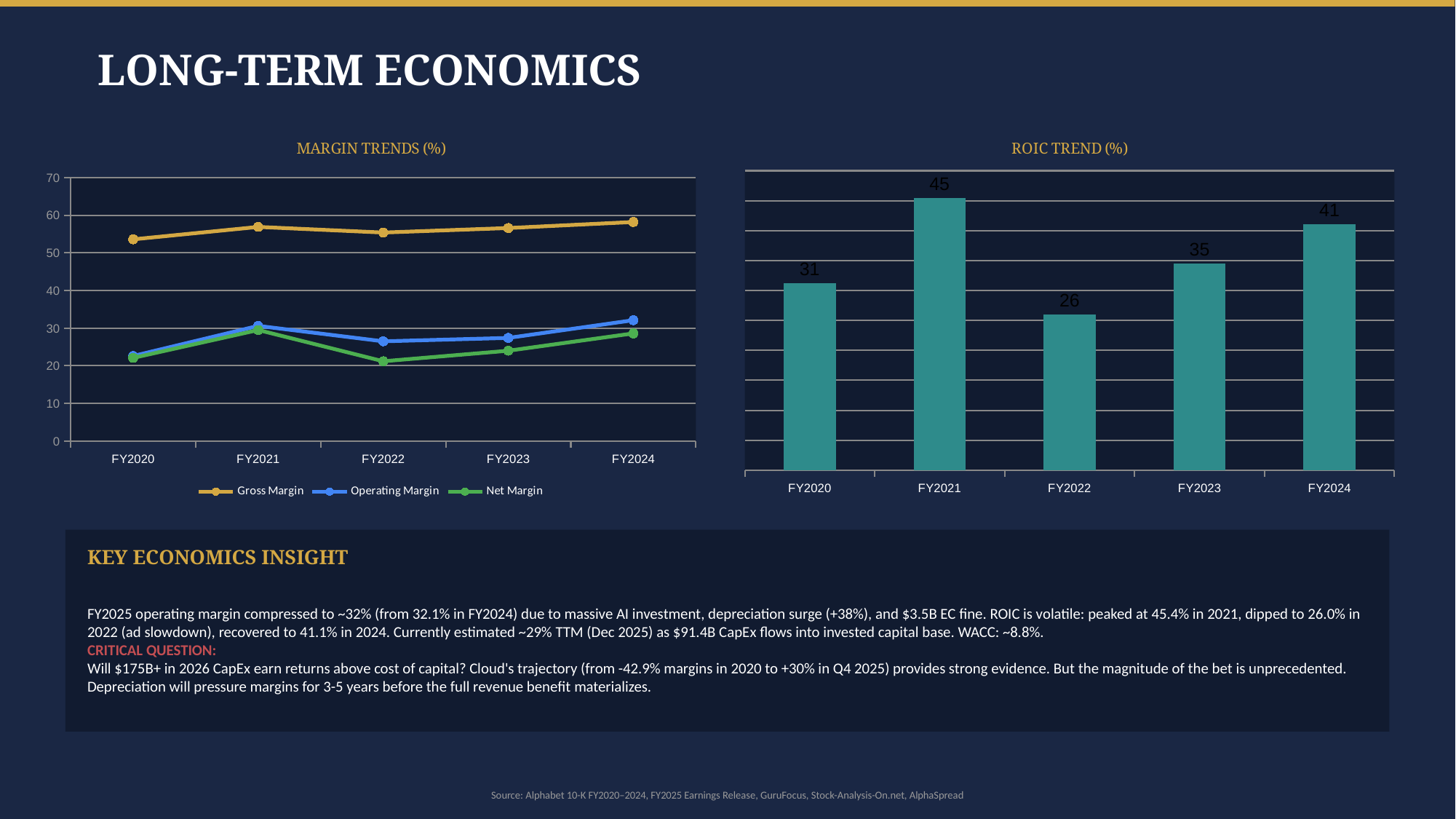
How many series does the legend of the MARGIN TRENDS (%) chart list? 3 In the MARGIN TRENDS (%) chart, which series has the lowest value in FY2022? Net Margin In the ROIC TREND (%) chart, which is larger, the value for FY2023 or FY2024? FY2024 In the MARGIN TRENDS (%) chart, is the Gross Margin value for FY2020 greater or less than 50? greater How many fiscal years are plotted on the x axis of the MARGIN TRENDS (%) chart? 5 In the MARGIN TRENDS (%) chart, is the Operating Margin value for FY2022 greater or less than 30? less What kind of chart is the ROIC TREND (%) chart? Bar chart In the ROIC TREND (%) chart, what is the ROIC value for FY2021? 45 In the ROIC TREND (%) chart, what is the ROIC value for FY2022? 26 In the ROIC TREND (%) chart, what is the difference between the FY2021 and FY2022 values? 19 In the ROIC TREND (%) chart, which fiscal year has the highest ROIC? FY2021 In the ROIC TREND (%) chart, which fiscal year has the lowest ROIC? FY2022